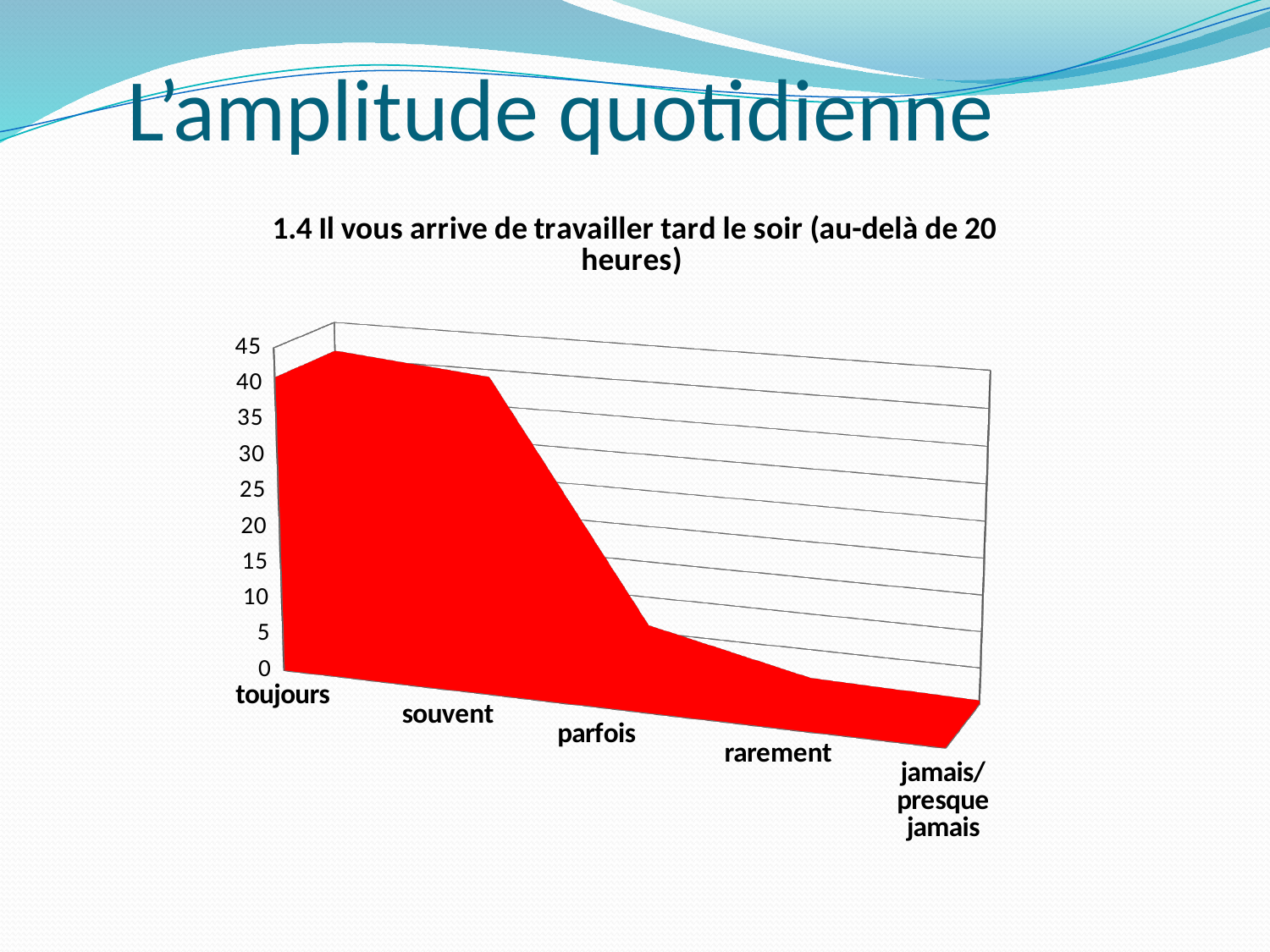
Is the value for 'rarement' greater or less than 10? less What is the title of the chart? 1.4 Il vous arrive de travailler tard le soir (au-delà de 20 heures) Which is larger, the value for 'souvent' or the value for 'rarement'? souvent Is the value for 'parfois' greater or less than 20? less What kind of chart is shown on the slide? area chart Is the value for 'toujours' greater or less than 30? greater Which is larger, the value for 'toujours' or the value for 'parfois'? toujours What colour is the plotted area in the chart? red How many categories are shown on the x axis of the chart? 5 What is the highest value shown on the vertical axis of the chart? 45 Do the values rise or fall moving from 'toujours' to 'jamais/presque jamais' along the x axis? fall